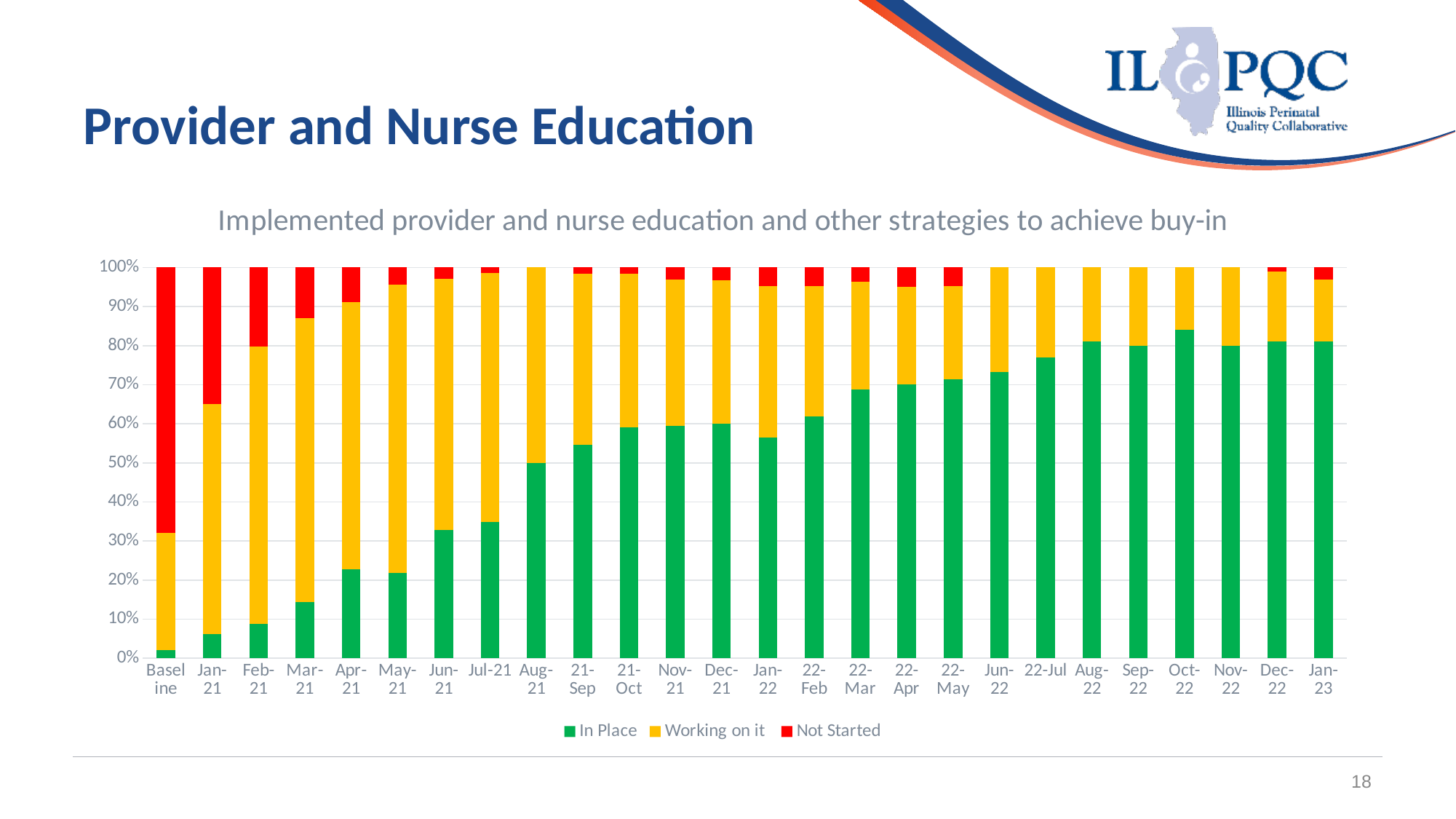
Which is larger, the 'In Place' share for Jan-21 or for Jan-22? Jan-22 Is the 'In Place' value for Jan-23 greater or less than 70%? greater Is the 'In Place' value for Baseline greater or less than 10%? less Which category has the lowest 'In Place' share? Baseline How many series does the legend list? 3 What kind of chart is shown on the slide? Stacked bar chart Is the 'Not Started' value for Baseline greater or less than 60%? greater Does the 'In Place' share generally rise or fall from Baseline to Jan-23? Rise How many time periods (categories) are shown along the x axis? 26 Which category has the highest 'Not Started' share? Baseline What is the title of the chart? Implemented provider and nurse education and other strategies to achieve buy-in